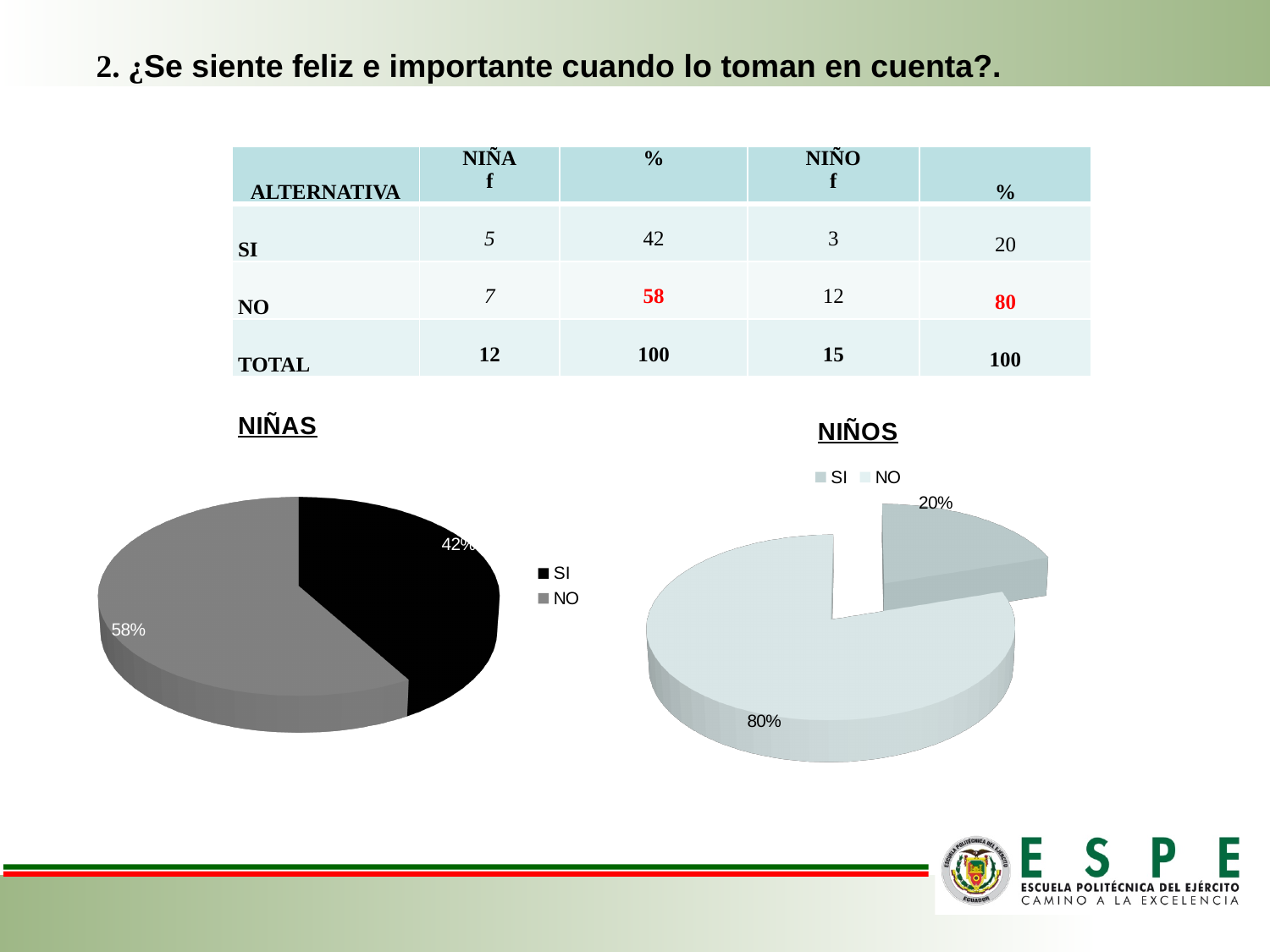
What entries does the legend of the NIÑAS pie chart list? SI, NO In the NIÑOS pie chart, what percentage is shown for NO? 80% In the NIÑOS pie chart, which category has the largest slice? NO What type of chart is the NIÑAS chart? Pie chart In the NIÑOS pie chart, what is the difference between the NO and SI percentages? 60% In the NIÑAS pie chart, which category has the smallest slice? SI In the NIÑOS pie chart, what percentage is shown for SI? 20% Which is larger: the NO share in the NIÑAS chart or the NO share in the NIÑOS chart? NIÑOS In the NIÑAS pie chart, what percentage is shown for SI? 42% In the NIÑAS pie chart, what percentage is shown for NO? 58% In the NIÑAS pie chart, what is the difference between the NO and SI percentages? 16% How many categories does the NIÑOS pie chart show? 2